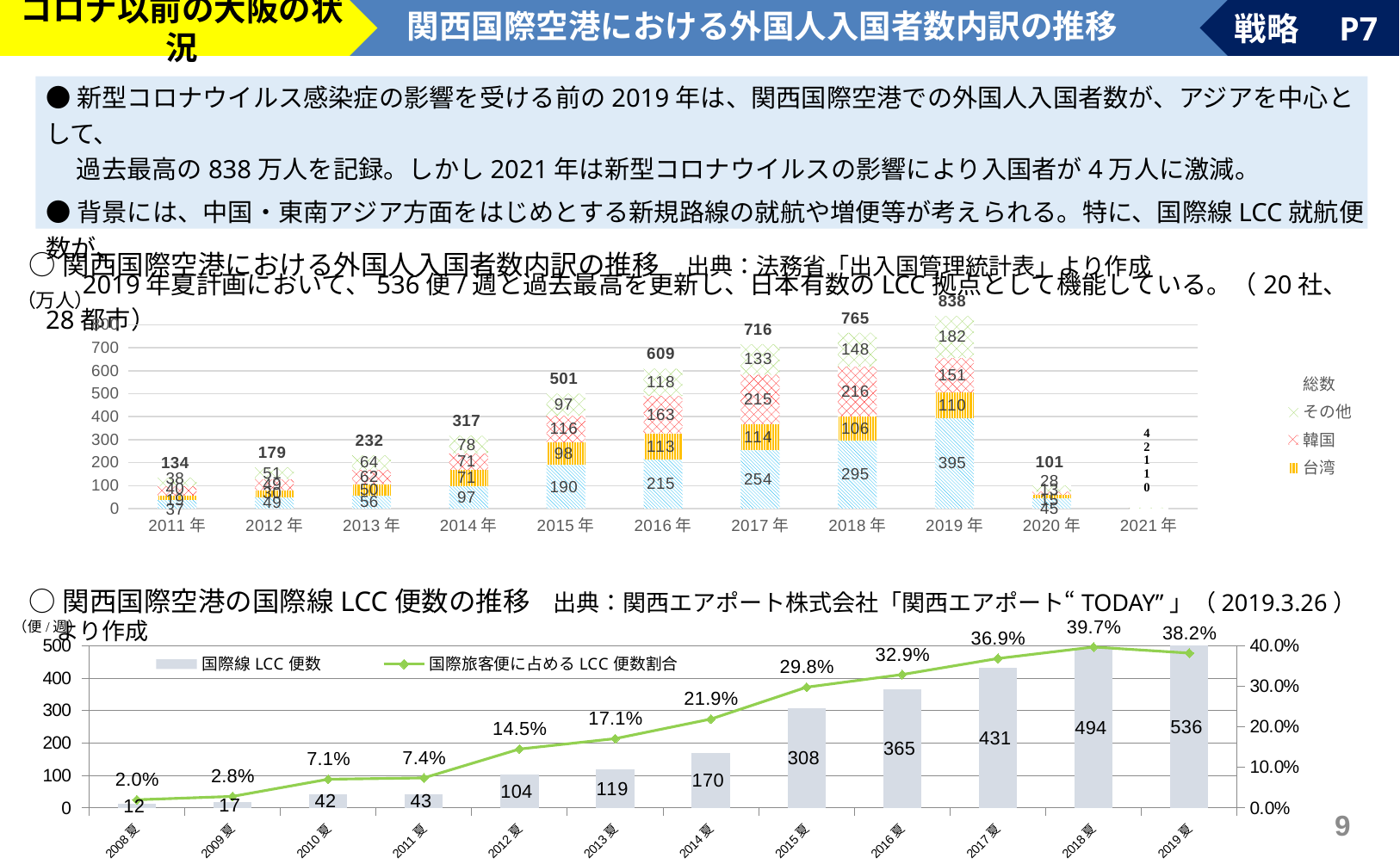
In the bottom chart, what is the difference in 国際線LCC便数 between 2019夏 and 2018夏? 42 In the bottom chart, what is the 国際旅客便に占めるLCC便数割合 for 2018夏? 39.7% In the bottom chart (関西国際空港の国際線LCC便数の推移), how many 国際線LCC便数 are shown for 2019夏? 536 In the top chart, how many years are shown on the x axis? 11 In the top chart, which year has the highest total number of foreign entrants? 2019年 In the top chart, which year has the lowest total number of foreign entrants? 2021年 In the bottom chart, do the 国際線LCC便数 bars rise or fall from 2008夏 to 2019夏? rise In the top chart, what is the difference between the totals for 2019年 and 2018年? 73 In the top chart (関西国際空港における外国人入国者数内訳の推移), what is the total (総数) for 2019年? 838 In the bottom chart, in which period is the LCC share (国際旅客便に占めるLCC便数割合) highest? 2018夏 In the top chart, which total is larger, 2016年 or 2017年? 2017年 In the top chart, what is the value for 台湾 in 2019年? 110